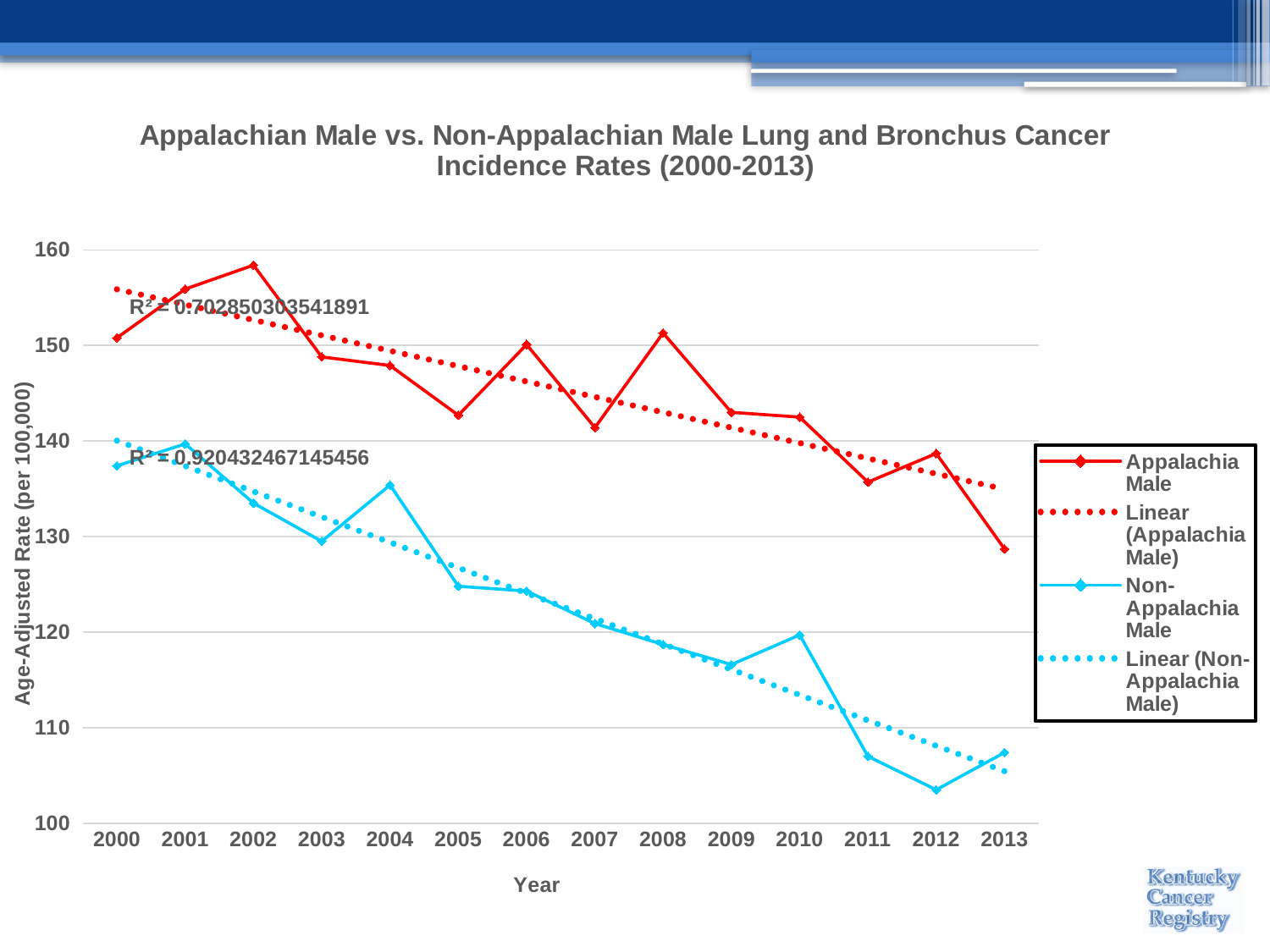
How many years are plotted along the x axis? 14 In which year is the Non-Appalachia Male rate lowest? 2012 Is the Non-Appalachia Male rate in 2012 greater or less than 110? less Is the Appalachia Male rate in 2013 greater or less than 130? less In 2008, which series has the higher rate, Appalachia Male or Non-Appalachia Male? Appalachia Male What R² value is shown for the Non-Appalachia Male linear trendline? R² = 0.920432467145456 Is the Appalachia Male rate in 2002 greater or less than 150? greater How many entries does the legend list? 4 In which year is the Appalachia Male rate highest? 2002 Do the Appalachia Male incidence rates generally rise or fall from 2000 to 2013? Fall In which year is the Appalachia Male rate lowest? 2013 What kind of chart is shown on the slide? Line chart